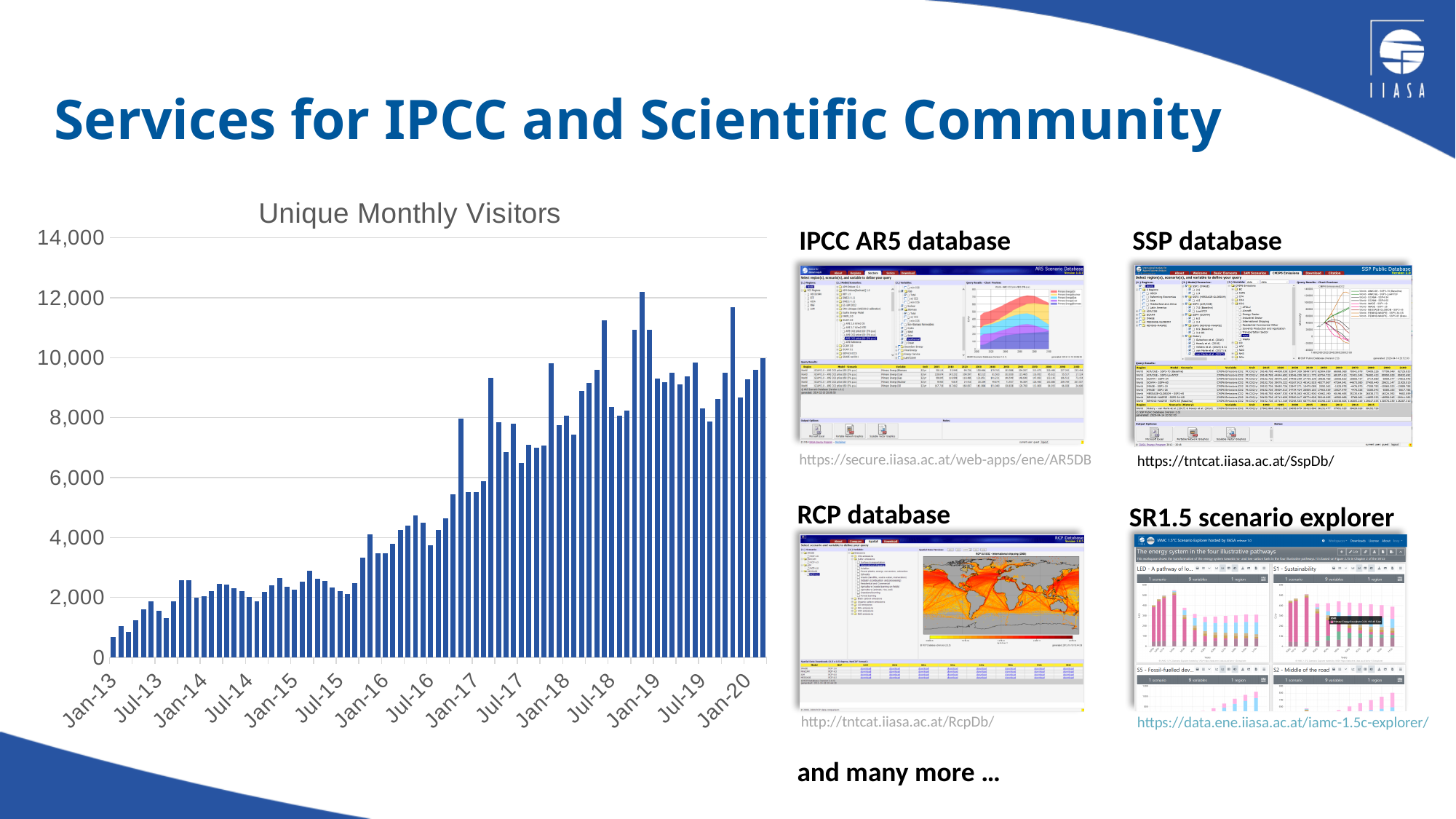
In the "Unique Monthly Visitors" chart, do the values generally rise or fall from Jan-13 to Jan-19? rise In the "Unique Monthly Visitors" chart, is the highest bar greater or less than 12,000? greater In the "Unique Monthly Visitors" chart, which is larger, the value for Jan-14 or the value for Jan-18? Jan-18 What kind of chart is the "Unique Monthly Visitors" chart? bar chart In the "Unique Monthly Visitors" chart, is the value for Jan-15 greater or less than 2,000? greater In the "Unique Monthly Visitors" chart, is the value for Jan-17 greater or less than 4,000? greater What is the title of the chart on the left of the slide? Unique Monthly Visitors What is the highest tick value shown on the y axis of the "Unique Monthly Visitors" chart? 14,000 In the "Unique Monthly Visitors" chart, which is larger, the value for Jan-13 or the value for Jan-20? Jan-20